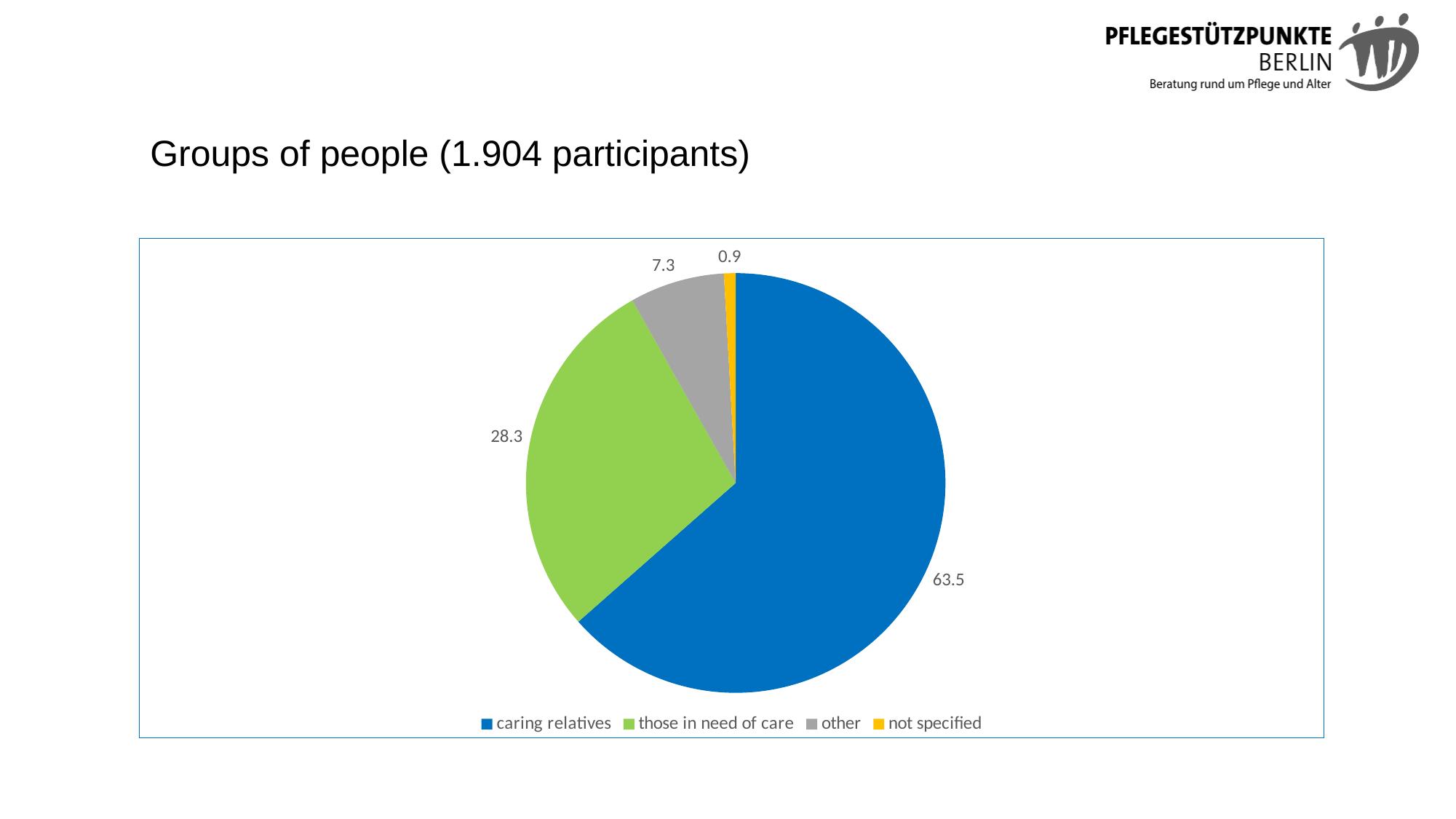
Which is larger, the value for other or the value for not specified? other What value is shown for the not specified slice? 0.9 What colour is the slice for those in need of care? green Which group has the largest slice of the pie? caring relatives What value is shown for the those in need of care slice? 28.3 What kind of chart is shown on the slide? pie chart How many slices does the pie chart have? 4 What value is shown for the caring relatives slice? 63.5 Which group has the smallest slice of the pie? not specified What is the difference between the values for caring relatives and those in need of care? 35.2 What is the title of the slide above the chart? Groups of people (1.904 participants) What value is shown for the other slice? 7.3